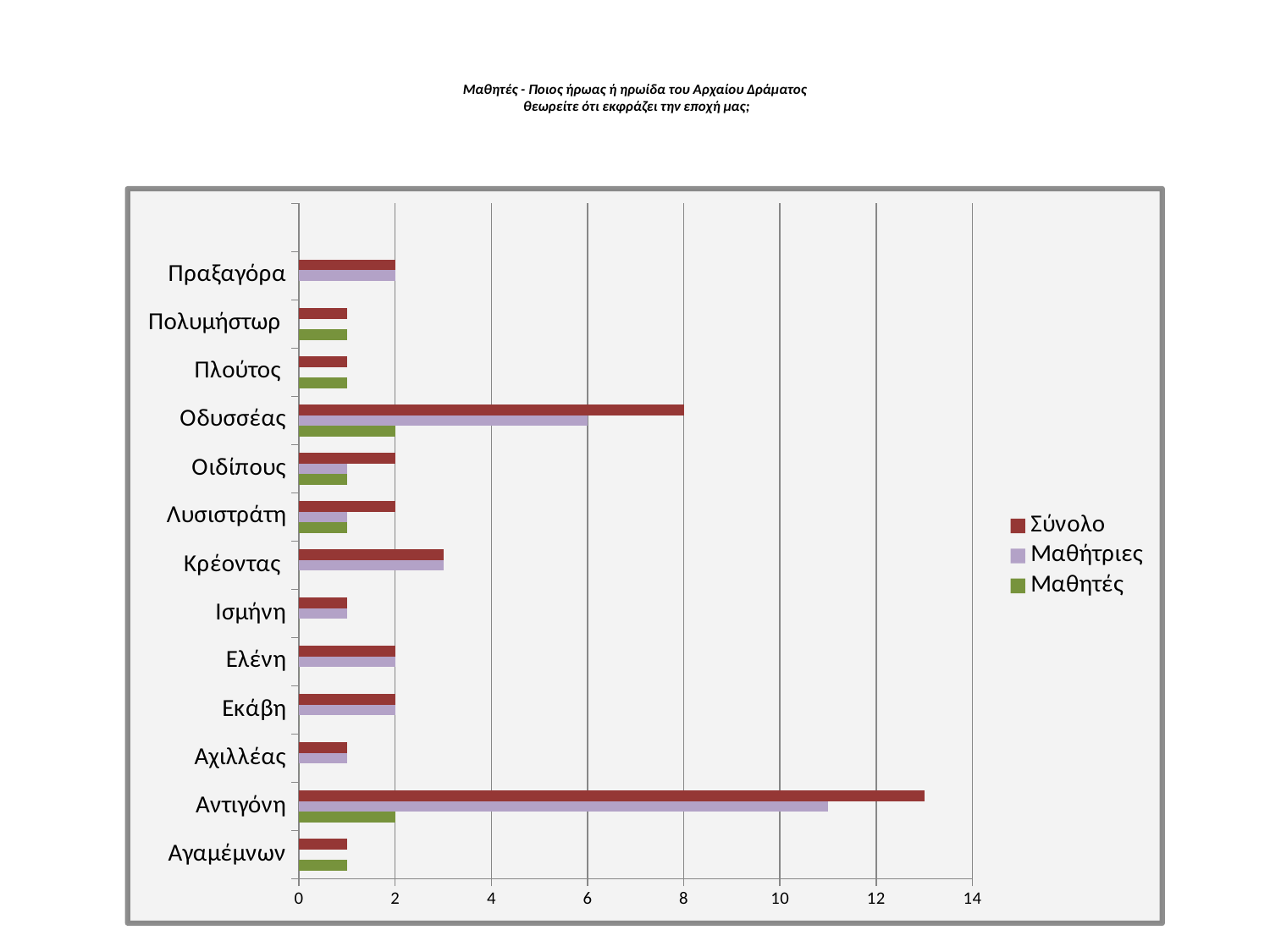
What is the Μαθήτριες value for Οδυσσέας? 6 Which category has the highest Σύνολο value? Αντιγόνη What is the Σύνολο value for Οδυσσέας? 8 Is the Μαθήτριες value for Αντιγόνη greater or less than 10? greater What is the difference between the Σύνολο and Μαθήτριες values for Οδυσσέας? 2 Which has the larger Σύνολο value, Οδυσσέας or Κρέοντας? Οδυσσέας How many series does the legend list? 3 Is the Σύνολο value for Αντιγόνη greater or less than 12? greater Which series is shown in green in the legend? Μαθητές What is the Σύνολο value for Πραξαγόρα? 2 How many categories (heroes/heroines) are shown on the chart? 13 What kind of chart is shown on the slide? bar chart